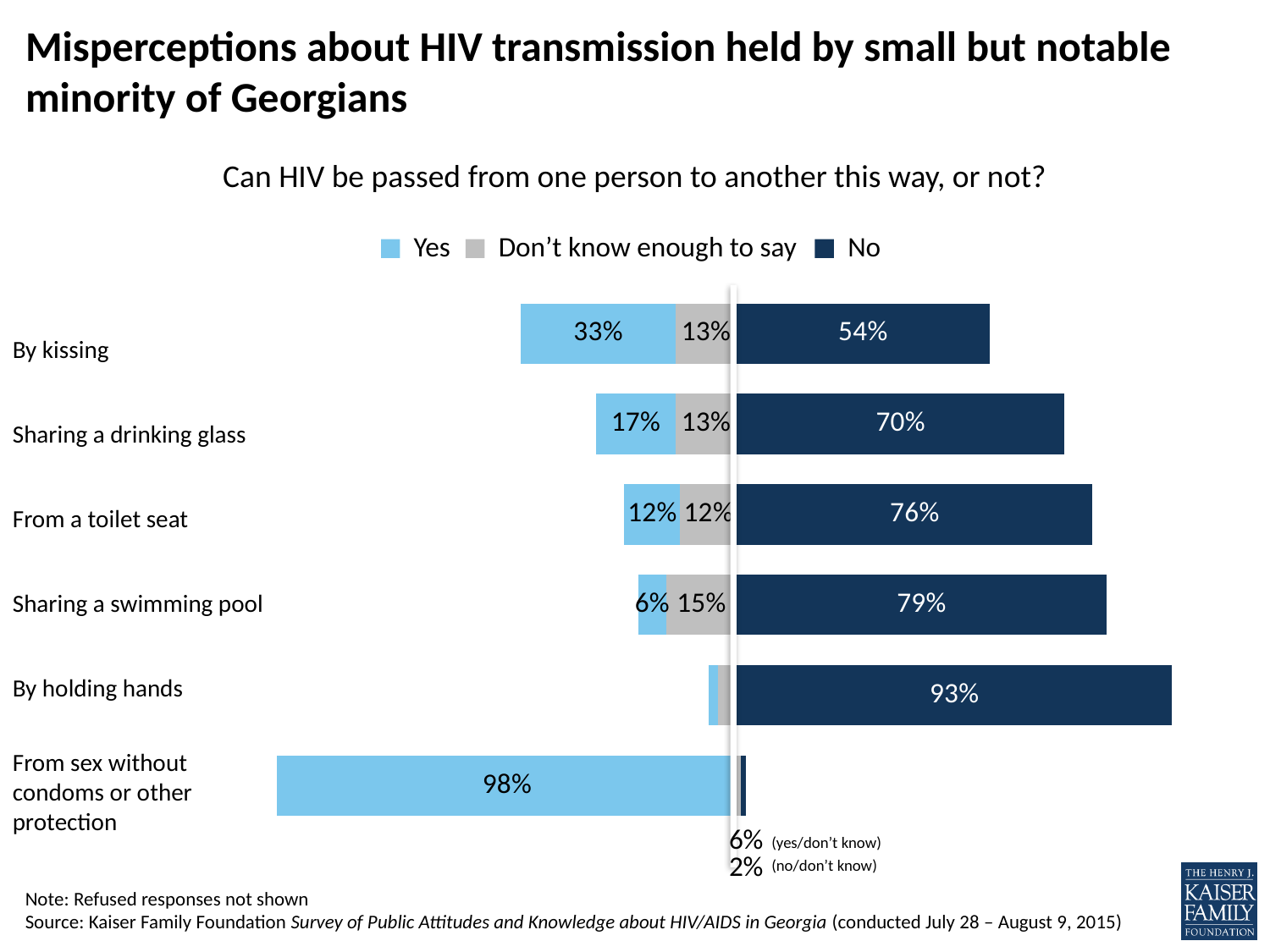
How many categories (ways of transmission) are shown in the chart? 6 What percentage said No to HIV being passed by sharing a drinking glass? 70% Which is larger: the Yes percentage for kissing or the Yes percentage for sharing a drinking glass? By kissing Which category has the highest No percentage? By holding hands What percentage said Yes to HIV being passed from sex without condoms or other protection? 98% What percentage said they don't know enough to say about HIV being passed by sharing a swimming pool? 15% What kind of chart is shown on the slide? Stacked bar chart What is the difference between the No percentage for a toilet seat and the No percentage for kissing? 22 percentage points Among the categories with a printed Yes value, which has the lowest Yes percentage? Sharing a swimming pool How many series does the legend list? 3 What is the total of the Yes, Don't know enough to say, and No values for the toilet seat bar? 100% What percentage of Georgians said HIV can be passed by kissing (Yes)? 33%